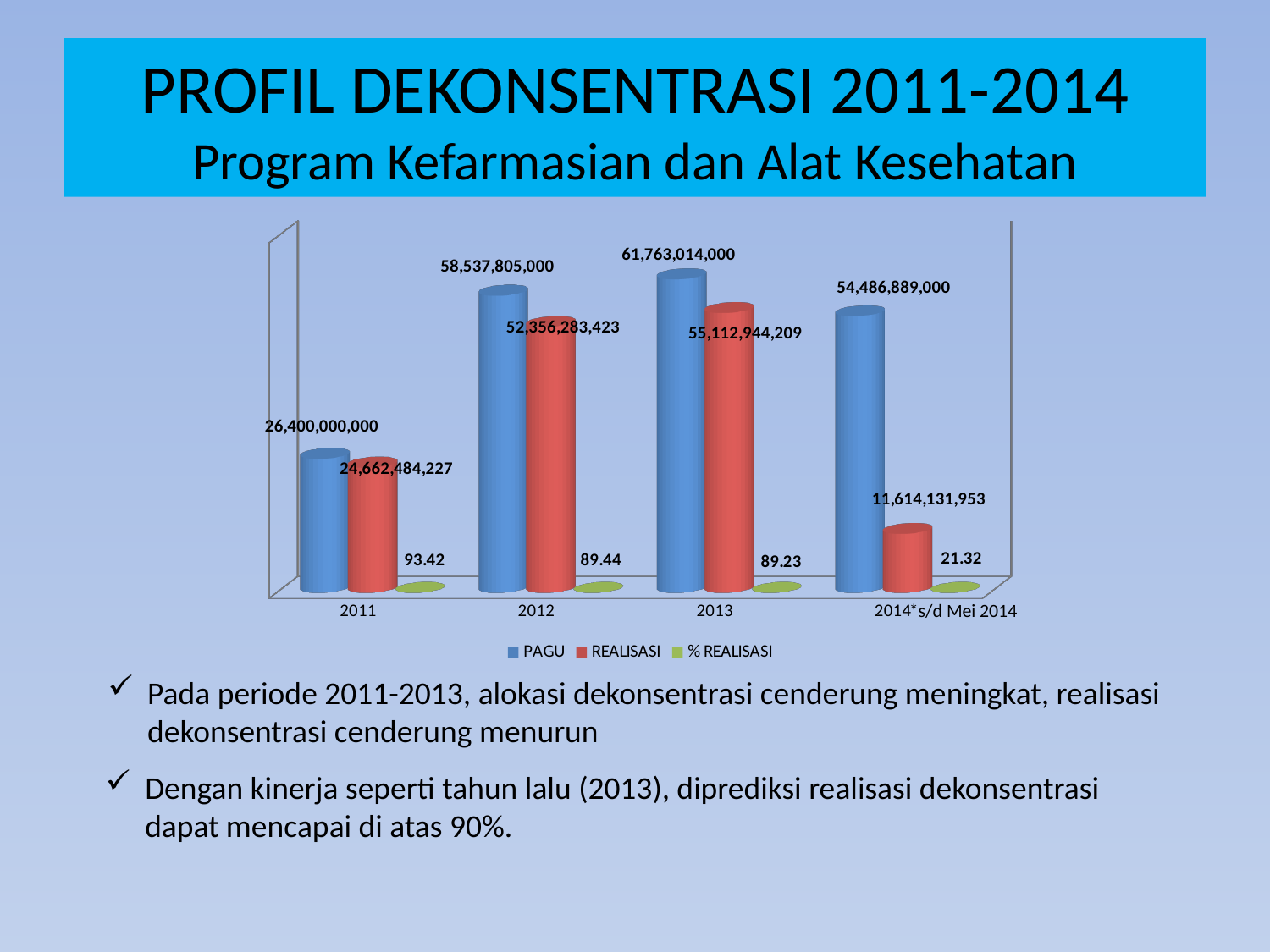
What is the difference between PAGU and REALISASI in 2013? 6,650,069,791 How many categories are shown on the x axis of the chart? 4 How many series does the chart legend list? 3 What type of chart is shown on the slide? Bar chart Which category has the lowest % REALISASI value? 2014*s/d Mei 2014 What is the REALISASI value for 2014*s/d Mei 2014? 11,614,131,953 Which year has the highest PAGU value? 2013 What is the REALISASI value for 2012? 52,356,283,423 What is the PAGU value for 2013? 61,763,014,000 What is the difference between the % REALISASI values for 2011 and 2014*s/d Mei 2014? 72.10 What is the % REALISASI value for 2011? 93.42 Which is larger, the PAGU value for 2012 or the PAGU value for 2014*s/d Mei 2014? 2012